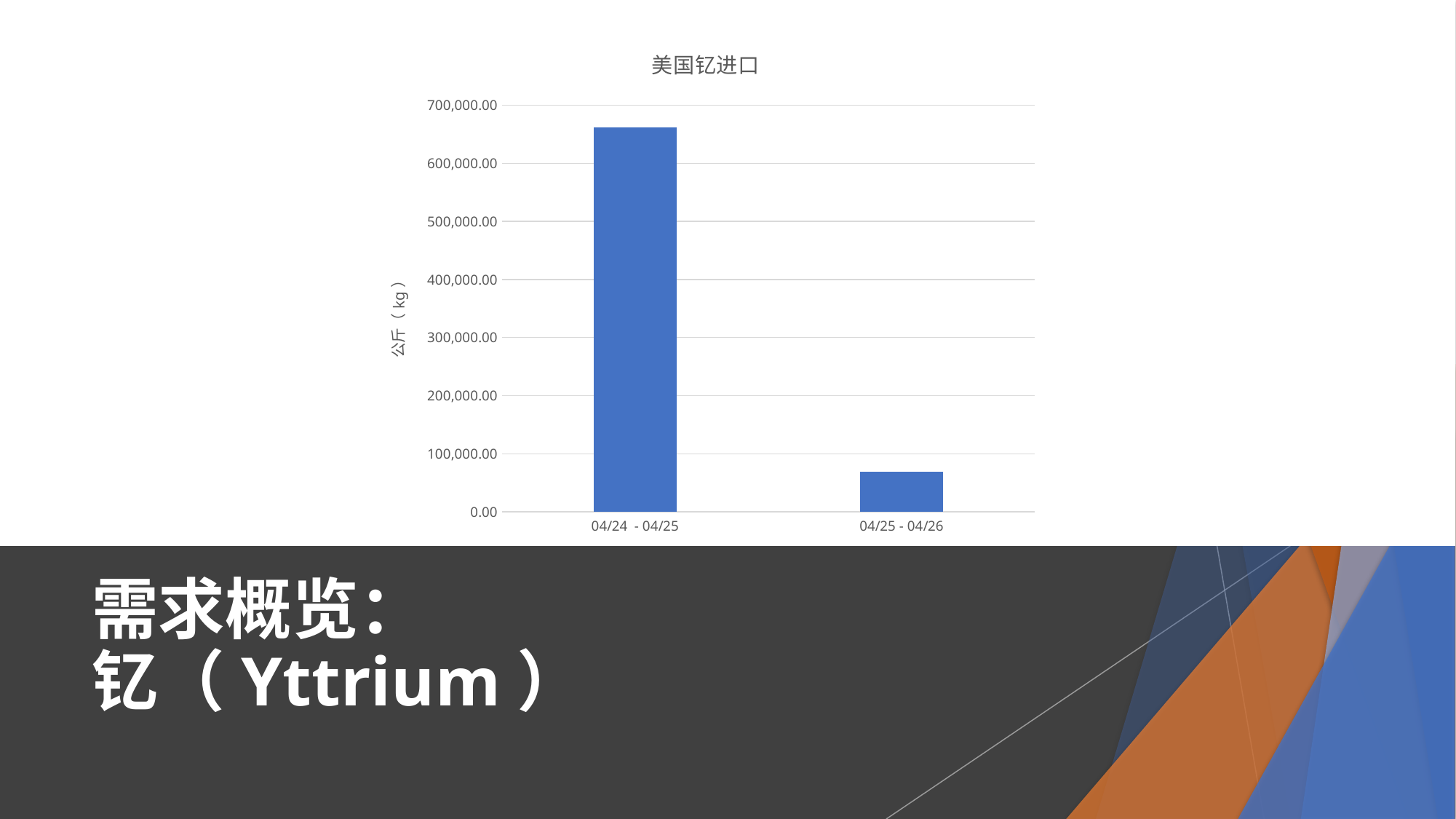
What is the label of the vertical axis of the chart? 公斤（kg） Is the value for 04/24 - 04/25 greater or less than 700,000.00? less Which period has the lowest value in the chart? 04/25 - 04/26 Which is larger, the value for 04/24 - 04/25 or the value for 04/25 - 04/26? 04/24 - 04/25 Is the value for 04/25 - 04/26 greater or less than 100,000.00? less Do the values rise or fall from 04/24 - 04/25 to 04/25 - 04/26? fall Which period has the highest value in the chart? 04/24 - 04/25 How many categories are shown on the x axis of the chart? 2 What is the title of the chart? 美国钇进口 What type of chart is shown on the slide? bar chart Is the value for 04/24 - 04/25 greater or less than 600,000.00? greater